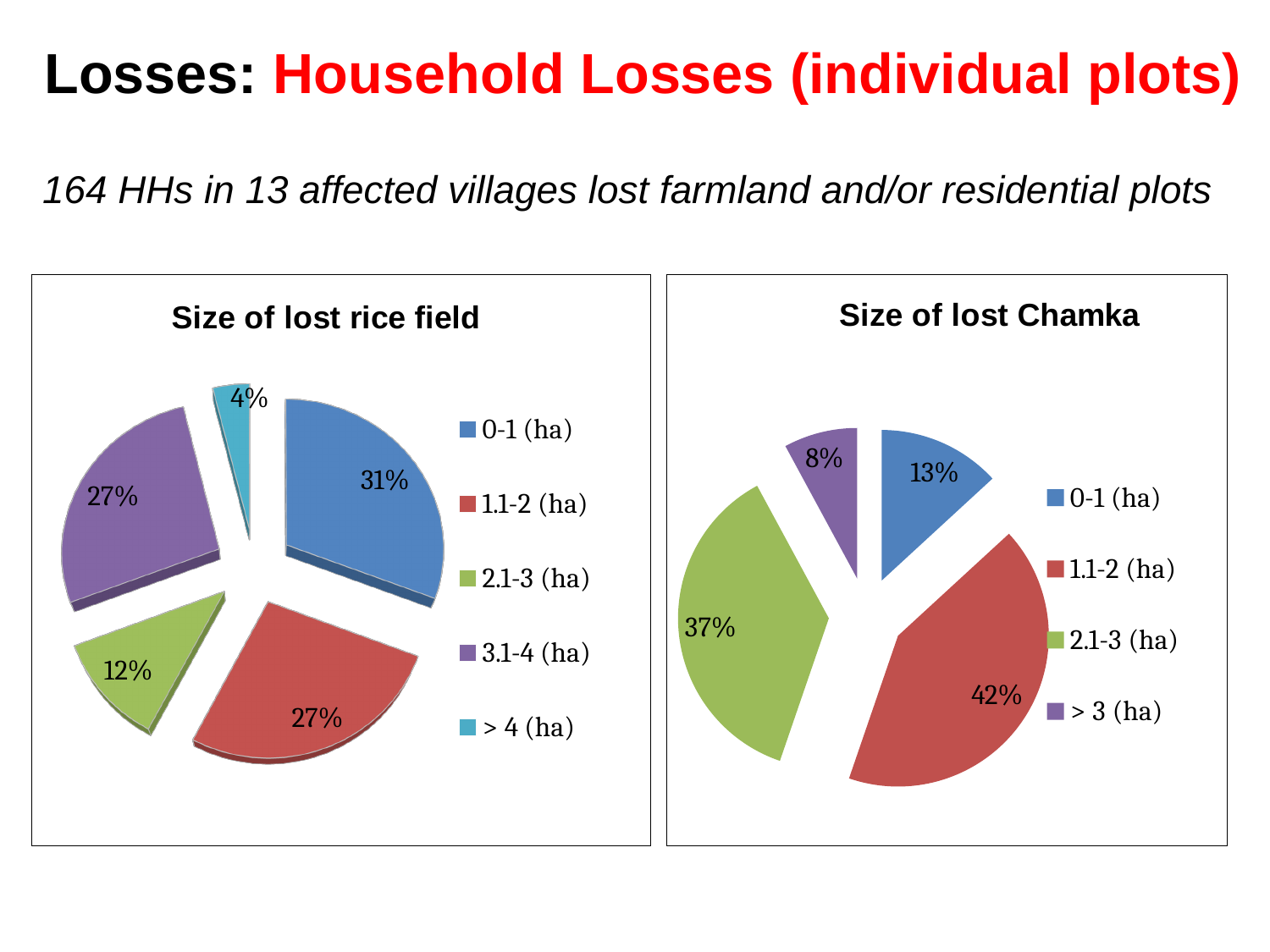
In the 'Size of lost Chamka' chart, what share of the pie is the 1.1-2 (ha) slice? 42% In the 'Size of lost Chamka' chart, what share of the pie is the 0-1 (ha) slice? 13% In the 'Size of lost Chamka' chart, which is larger, the 2.1-3 (ha) share or the 0-1 (ha) share? 2.1-3 (ha) In the 'Size of lost rice field' chart, which category has the smallest share? > 4 (ha) In the 'Size of lost rice field' chart, what share of the pie is the > 4 (ha) slice? 4% In the 'Size of lost rice field' chart, what is the difference between the 0-1 (ha) share and the 2.1-3 (ha) share? 19% In the 'Size of lost rice field' chart, which category has the largest share? 0-1 (ha) In the 'Size of lost Chamka' chart, which category has the largest share? 1.1-2 (ha) In the 'Size of lost Chamka' chart, which category has the smallest share? > 3 (ha) In the 'Size of lost rice field' chart, how many categories does the legend list? 5 What kind of chart is the 'Size of lost Chamka' chart? Pie chart